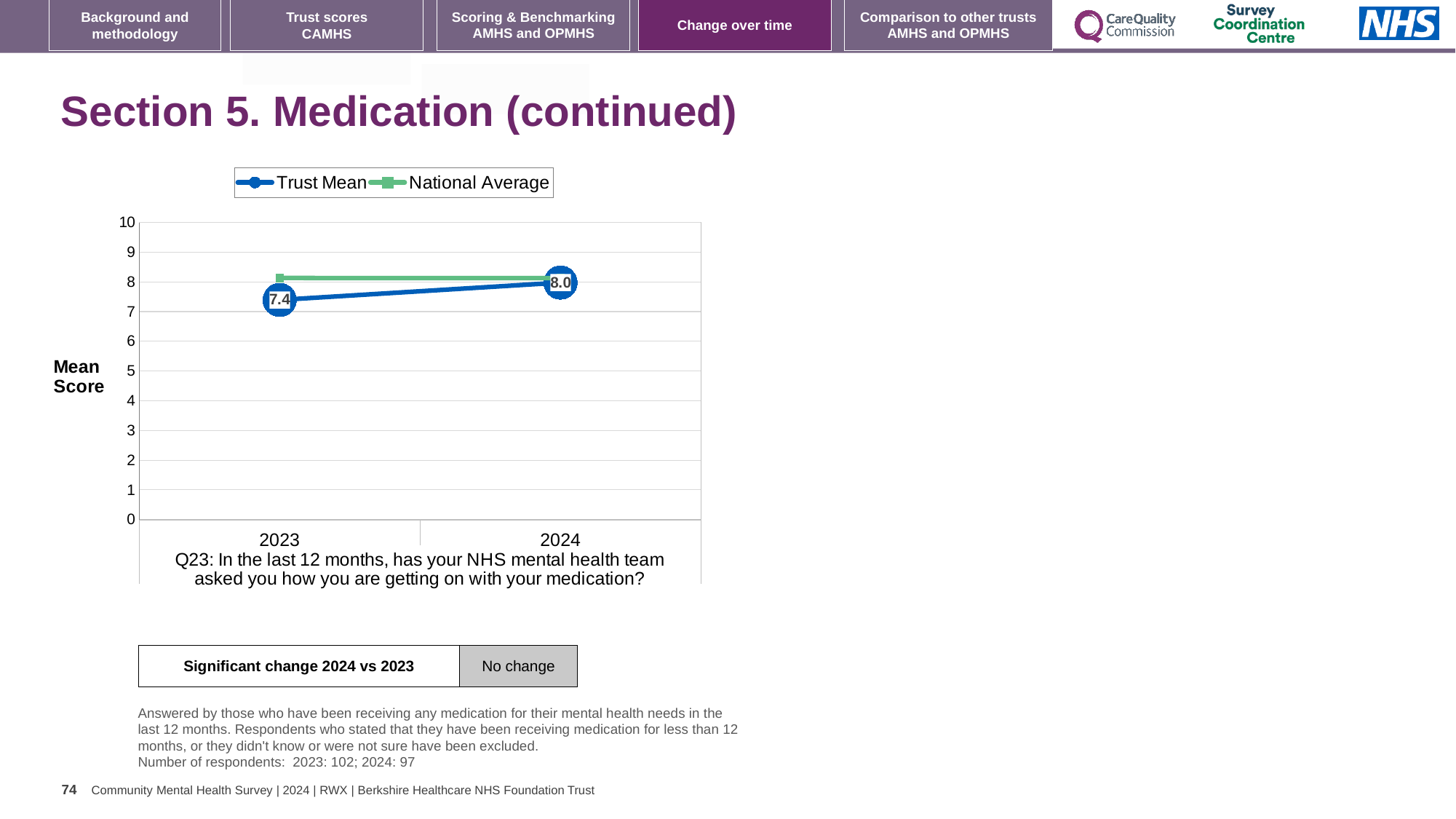
How many series does the legend list? 2 Does the Trust Mean rise or fall from 2023 to 2024? rise What is the Trust Mean value for 2024? 8.0 What kind of chart is shown on the slide? line chart By how much did the Trust Mean change from 2023 to 2024? 0.6 In 2023, which is larger, the Trust Mean or the National Average? National Average In which year is the Trust Mean lower? 2023 What is the Trust Mean value for 2023? 7.4 Is the National Average value for 2024 greater or less than 9? less How many years are shown on the x axis? 2 Is the National Average value for 2023 greater or less than 7? greater In which year is the Trust Mean higher? 2024